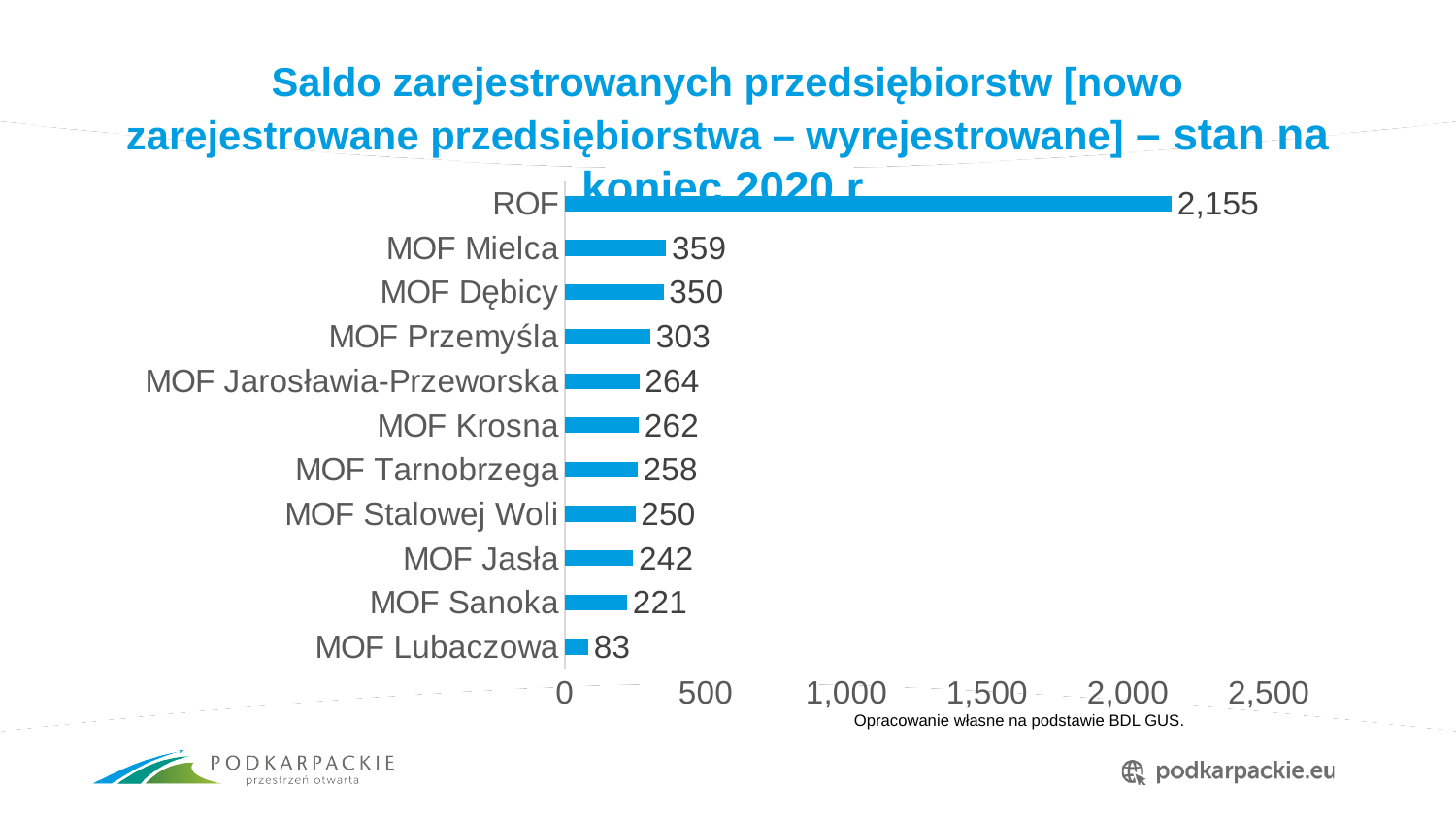
Which is larger, the value for MOF Przemyśla or the value for MOF Sanoka? MOF Przemyśla What is the value for MOF Mielca? 359 What is the difference between the values for MOF Mielca and MOF Dębicy? 9 How many categories are shown in the chart? 11 What is the value for MOF Jarosławia-Przeworska? 264 What is the value for MOF Lubaczowa? 83 Is the value for ROF greater or less than 2,000? greater What is the value for ROF? 2,155 What kind of chart is shown on the slide? bar chart Which category has the highest value? ROF What is the difference between the values for ROF and MOF Lubaczowa? 2,072 Which category has the lowest value? MOF Lubaczowa